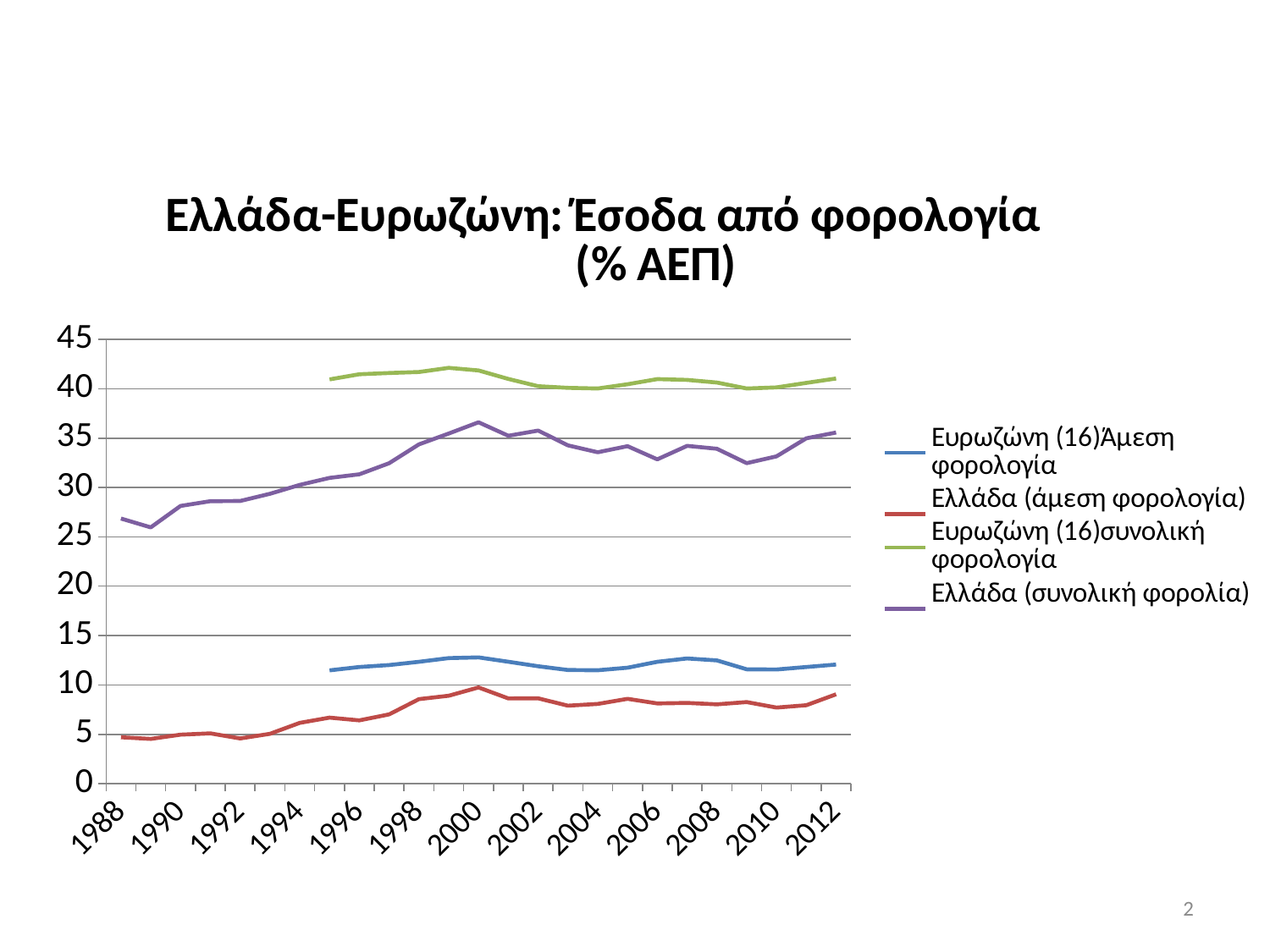
Is the value for Ευρωζώνη (16) Άμεση φορολογία in 2012 greater or less than 15? less What kind of chart is shown on the slide? line chart How many series does the legend list? 4 Is the value for Ελλάδα (άμεση φορολογία) in 1988 greater or less than 10? less Is the value for Ευρωζώνη (16) συνολική φορολογία in 2000 greater or less than 40? greater What is the title of the chart? Ελλάδα-Ευρωζώνη: Έσοδα από φορολογία (% ΑΕΠ) In 2000, which is larger: Ελλάδα (συνολική φορολία) or Ευρωζώνη (16) συνολική φορολογία? Ευρωζώνη (16) συνολική φορολογία What colour is the line for Ελλάδα (συνολική φορολία)? purple Which series has the lowest values across the chart? Ελλάδα (άμεση φορολογία) Does the Ελλάδα (συνολική φορολία) line rise or fall from 1988 to 2000? rise Which series has the highest values across the chart? Ευρωζώνη (16) συνολική φορολογία